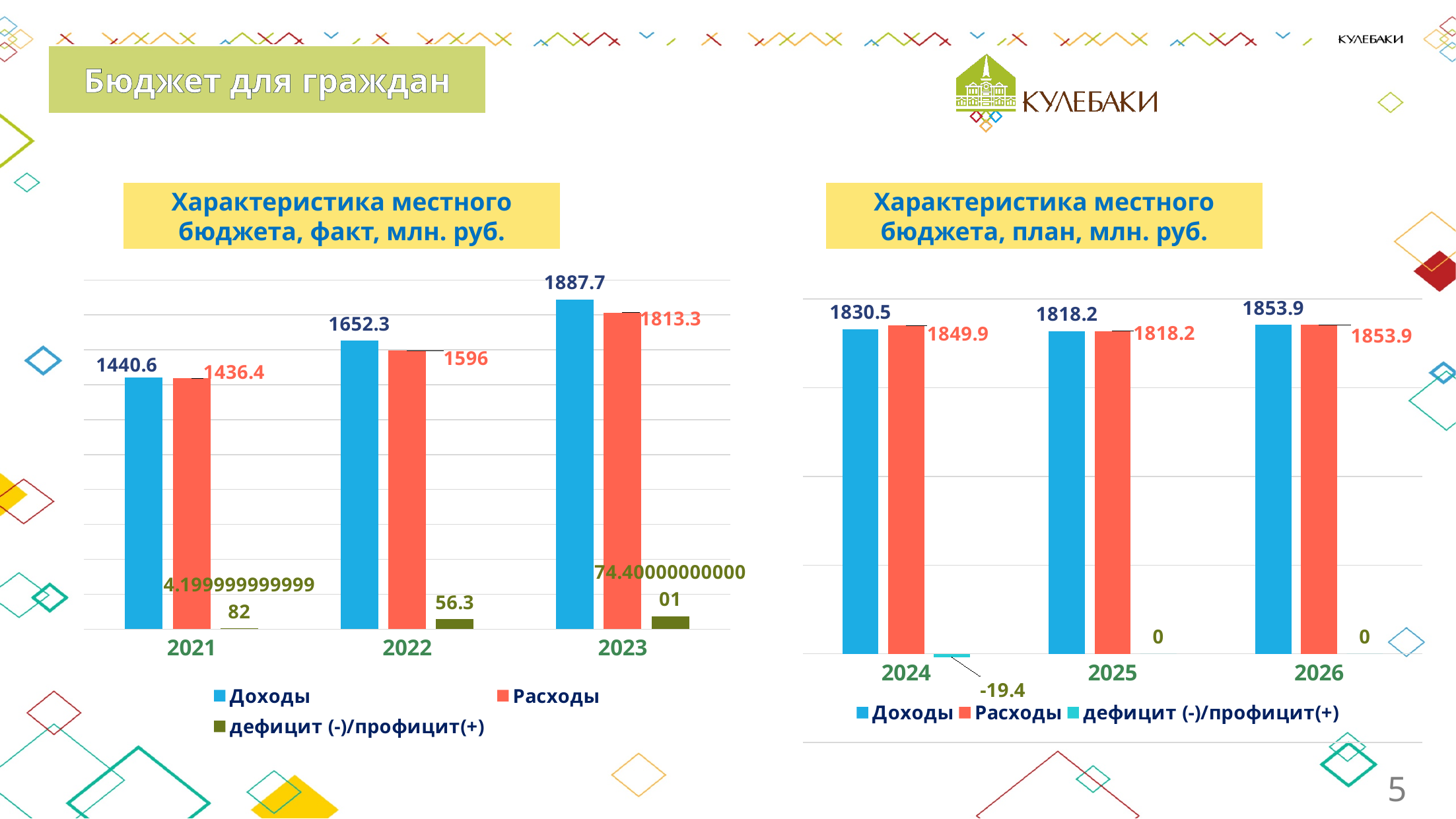
What type of chart is the chart titled 'Характеристика местного бюджета, план, млн. руб.'? bar chart In the chart titled 'Характеристика местного бюджета, факт, млн. руб.', what is the difference between Доходы and Расходы in 2022? 56.3 In the chart titled 'Характеристика местного бюджета, факт, млн. руб.', which year has the highest Доходы? 2023 In the chart titled 'Характеристика местного бюджета, факт, млн. руб.', what is the value of Доходы for 2023? 1887.7 In the chart titled 'Характеристика местного бюджета, план, млн. руб.', how many years are shown on the x axis? 3 In the chart titled 'Характеристика местного бюджета, план, млн. руб.', what is the value of Расходы for 2024? 1849.9 In the chart titled 'Характеристика местного бюджета, факт, млн. руб.', what is the value of Расходы for 2022? 1596 In the chart titled 'Характеристика местного бюджета, план, млн. руб.', what is the value of дефицит (-)/профицит(+) for 2024? -19.4 In the chart titled 'Характеристика местного бюджета, факт, млн. руб.', do the Доходы values rise or fall from 2021 to 2023? rise In the chart titled 'Характеристика местного бюджета, факт, млн. руб.', what is the value of дефицит (-)/профицит(+) for 2022? 56.3 In the chart titled 'Характеристика местного бюджета, план, млн. руб.', which is larger in 2024, Доходы or Расходы? Расходы In the chart titled 'Характеристика местного бюджета, факт, млн. руб.', how many series does the legend list? 3